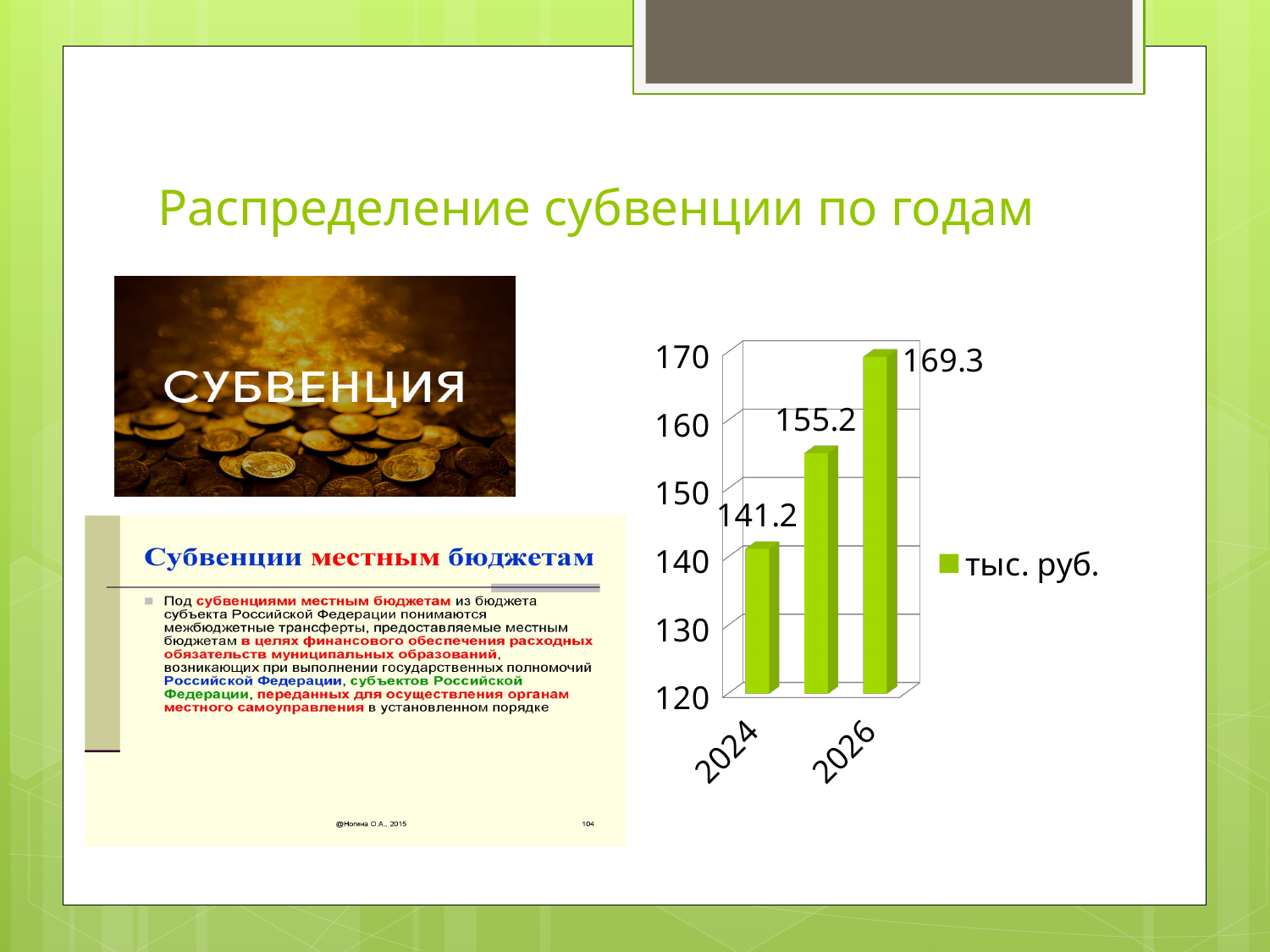
Which year has the lowest value? 2024 Is the value for 2024 greater or less than 150? less Is the value for 2026 greater or less than 160? greater Do the values rise or fall from left to right along the x axis? rise How many bars are plotted in the chart? 3 What is the value for 2026? 169.3 How many series does the legend list? 1 What is the difference between the values for 2026 and 2024? 28.1 Which year has the highest value? 2026 What is the value for 2024? 141.2 What kind of chart is shown on the slide? bar chart Which is larger, the value for 2024 or the value for 2026? 2026